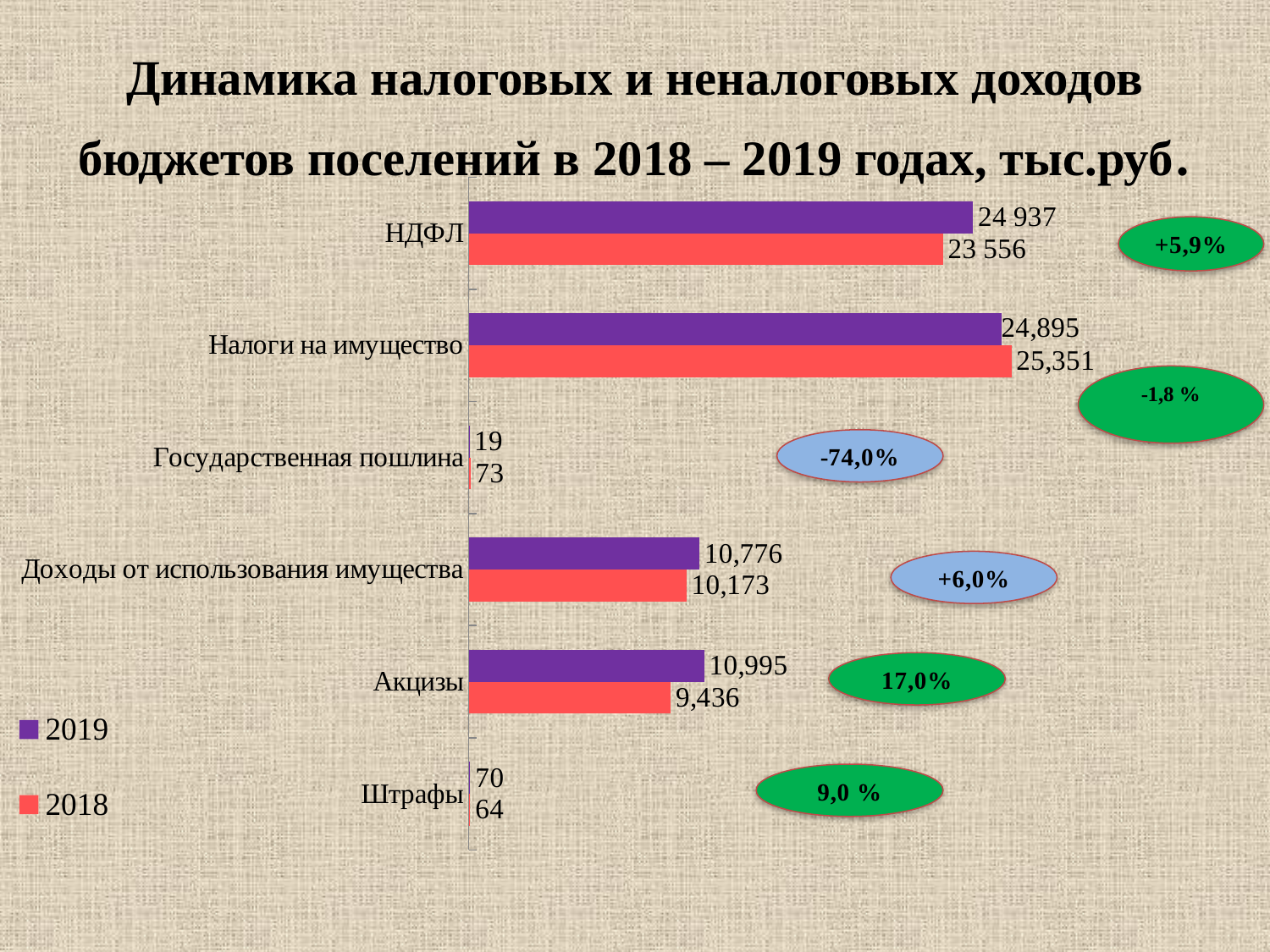
What is the 2019 value for НДФЛ? 24 937 What is the 2018 value for Государственная пошлина? 73 Which category has the lowest 2019 value? Государственная пошлина How many categories are shown on the chart? 6 Which category has the highest 2018 value? Налоги на имущество What is the difference between the 2018 and 2019 values for Государственная пошлина? 54 For Налоги на имущество, which year has the larger value, 2018 or 2019? 2018 What type of chart is shown on the slide? Bar chart What is the 2019 value for Акцизы? 10,995 What is the difference between the 2019 and 2018 values for Акцизы? 1,559 What is the 2018 value for Налоги на имущество? 25,351 How many series does the legend list? 2